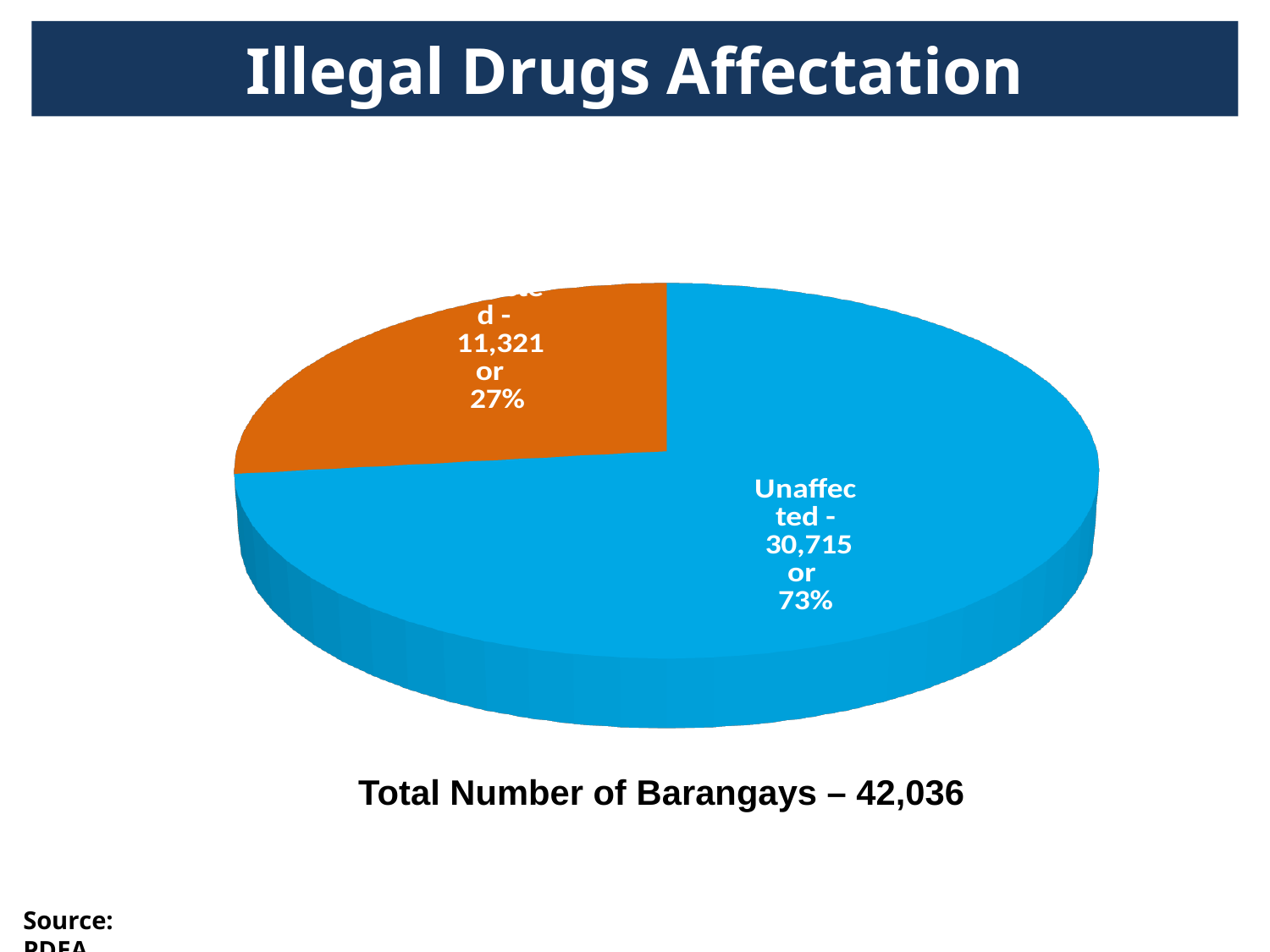
What is the title of the slide containing the pie chart? Illegal Drugs Affectation What is the number of Unaffected barangays shown on the pie chart? 30,715 What is the difference between the Unaffected value (30,715) and the orange slice value (11,321)? 19,394 What share of the pie does the Unaffected slice represent? 73% What is the total number of barangays stated below the pie chart? 42,036 What percentage is printed on the orange slice of the pie chart? 27% Which category has the largest slice in the pie chart? Unaffected What colour is the Unaffected slice of the pie chart? blue What kind of chart is shown on the slide? pie chart Which slice is larger, the blue slice or the orange slice? the blue slice How many slices does the pie chart have? 2 What value is printed on the orange slice of the pie chart? 11,321